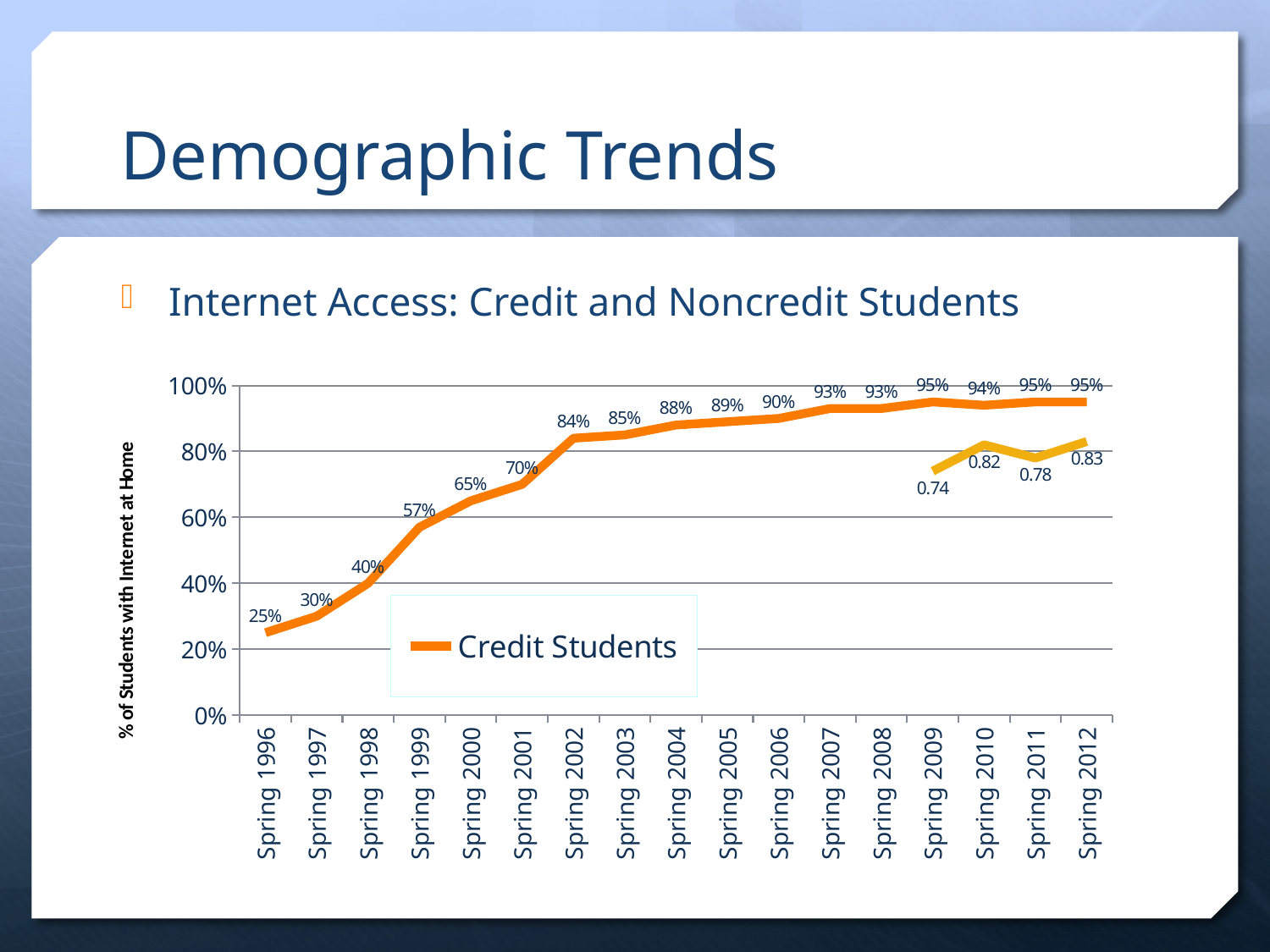
In which year does the Credit Students line have its lowest value? Spring 1996 What kind of chart is shown on the slide? line chart What is the Credit Students value for Spring 2002? 84% Does the Credit Students line generally rise or fall from Spring 1996 to Spring 2012? rise What value is labelled on the yellow line at Spring 2011? 0.78 How many series does the legend list? 1 What value is labelled on the yellow line at Spring 2009? 0.74 What is the difference between the Credit Students values for Spring 2002 and Spring 1996? 59% Which is larger, the Credit Students value for Spring 2001 or for Spring 2003? Spring 2003 Is the Credit Students value for Spring 1998 greater or less than 60%? less What is the Credit Students value for Spring 1999? 57% How many Spring terms are shown on the x axis? 17